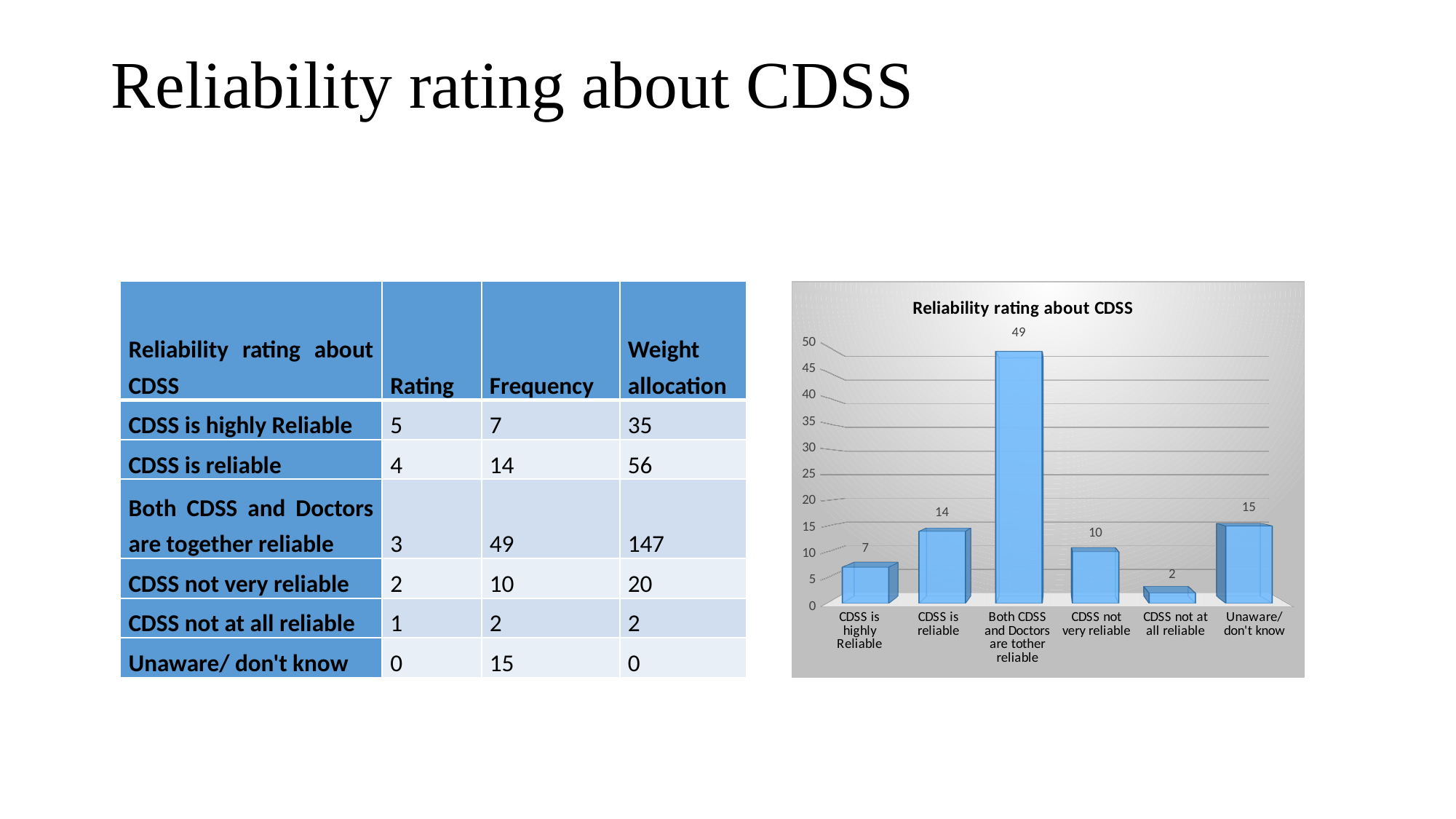
What is the value for 'CDSS is reliable' in the chart? 14 What is the value for 'Both CDSS and Doctors are tother reliable' in the chart? 49 Which is larger: the value for 'CDSS not very reliable' or the value for 'Unaware/ don't know'? Unaware/ don't know What is the difference between the values for 'Both CDSS and Doctors are tother reliable' and 'CDSS is reliable'? 35 What is the value for 'CDSS is highly Reliable' in the chart? 7 Which category has the lowest value in the chart? CDSS not at all reliable Is the value for 'CDSS is reliable' greater or less than 10? greater What is the value for 'Unaware/ don't know' in the chart? 15 What kind of chart is shown on the slide? bar chart How many categories are shown on the x axis of the chart? 6 What is the title of the chart? Reliability rating about CDSS Which category has the highest value in the chart? Both CDSS and Doctors are tother reliable